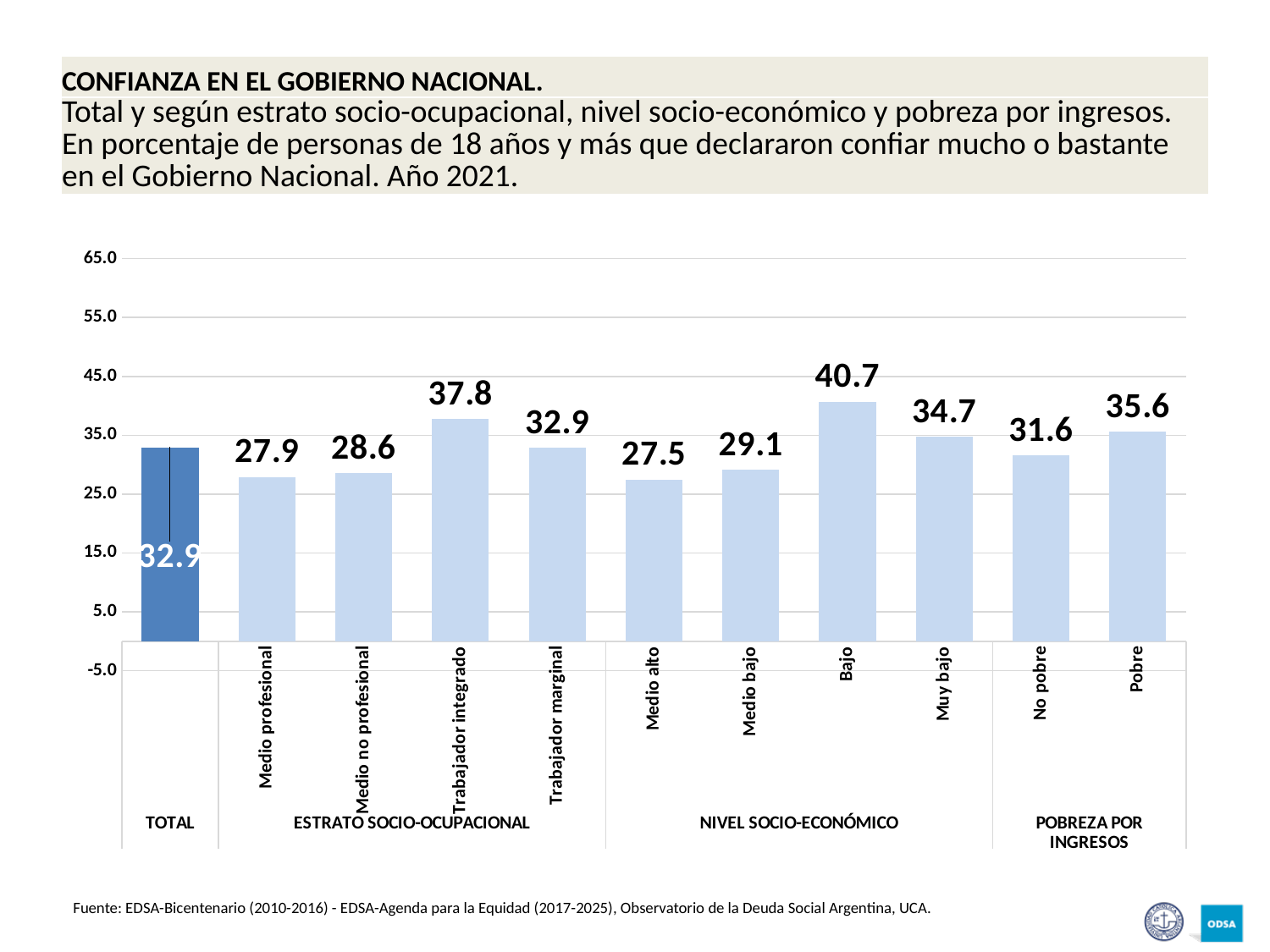
What is the value for Pobre? 35.6 What is the value for the TOTAL bar? 32.9 Which category has the highest value? Bajo What is the difference between the values for Pobre and No pobre? 4.0 What is the value for Trabajador integrado? 37.8 What is the value for Medio alto? 27.5 What is the difference between the values for Bajo and Muy bajo? 6.0 Is the value for Bajo greater or less than 35.0? greater Which is larger, the value for Medio profesional or the value for Medio no profesional? Medio no profesional Which category has the lowest value? Medio alto What kind of chart is shown on the slide? Bar chart How many bars are shown in the chart? 11